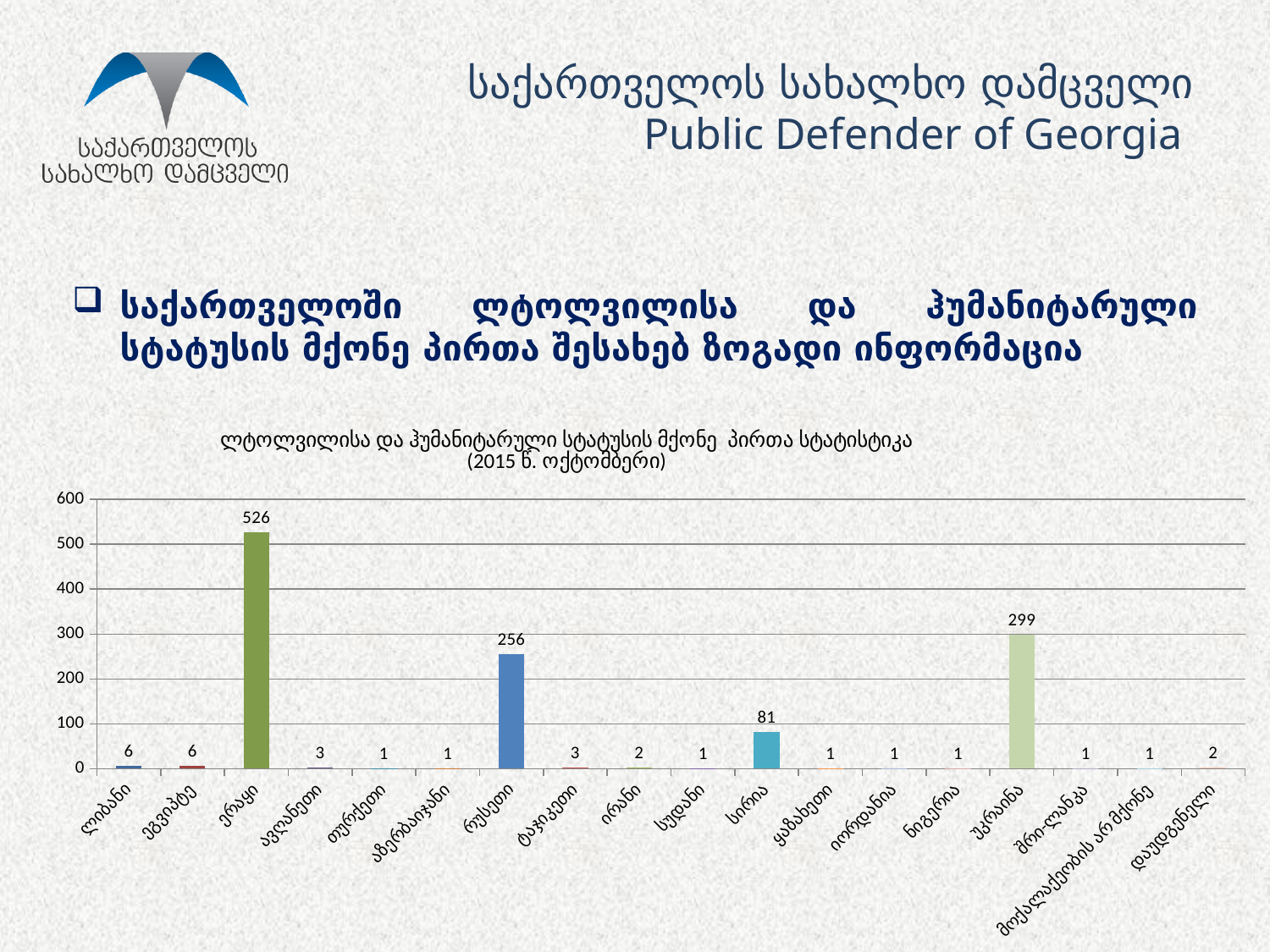
What year and month does the chart title say the statistics refer to? 2015 წ. ოქტომბერი How many categories are shown on the x axis? 18 What kind of chart is shown on the slide? bar chart Is the value for ერაყი greater or less than 500? greater What is the difference between the values for უკრაინა and რუსეთი? 43 Which is larger, the value for რუსეთი or the value for უკრაინა? უკრაინა What is the difference between the values for ერაყი and უკრაინა? 227 What is the value for სირია? 81 What is the value for რუსეთი? 256 What is the value for უკრაინა? 299 Which category has the highest value? ერაყი What is the value for ერაყი? 526